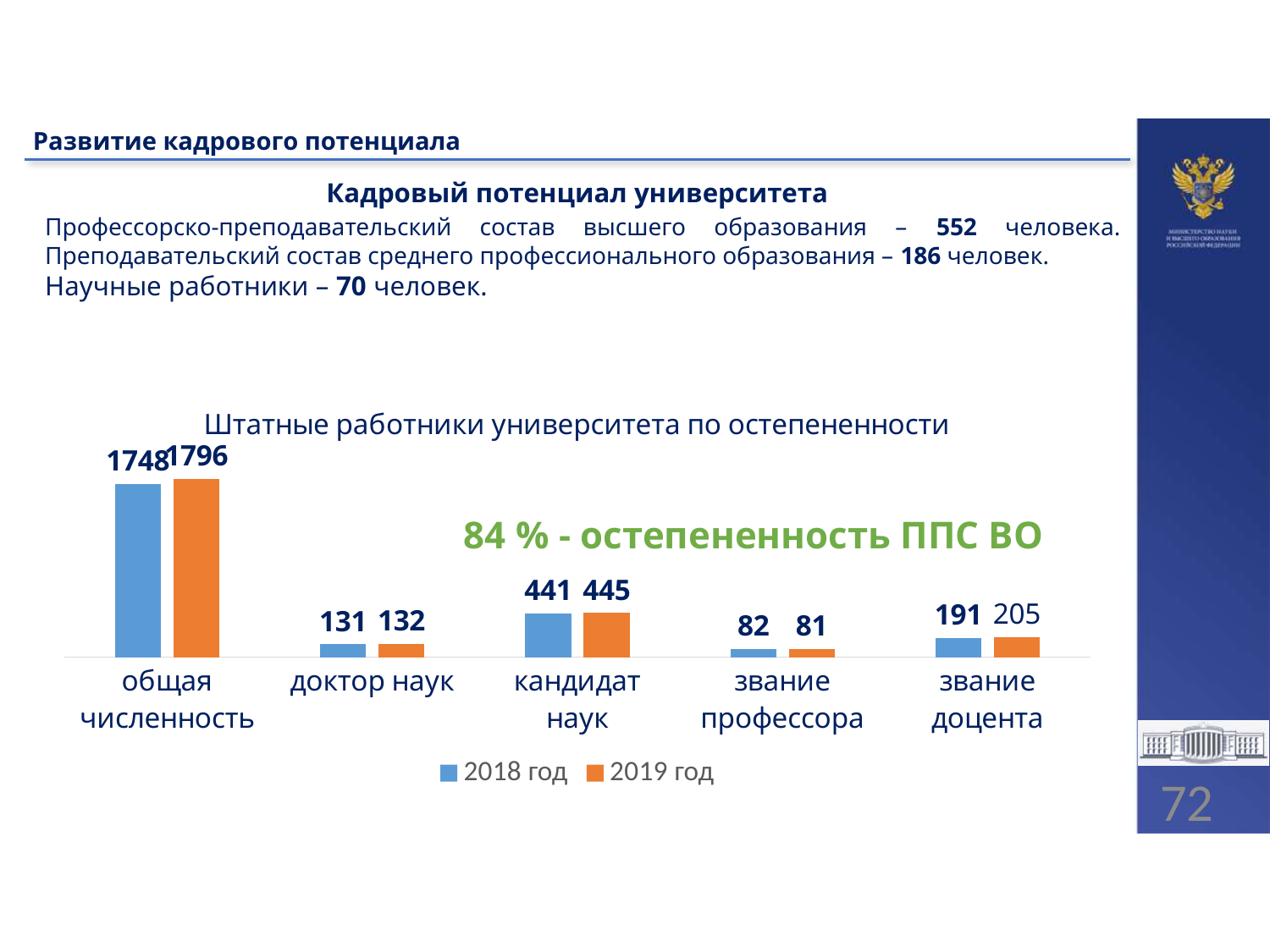
What is the value for 'звание доцента' in the 2018 год series? 191 What type of chart is 'Штатные работники университета по остепененности'? bar chart Which category has the highest value in the 2018 год series? общая численность How many series does the chart legend list? 2 For 'звание профессора', which series has the larger value, 2018 год or 2019 год? 2018 год What is the value for 'доктор наук' in the 2018 год series? 131 What is the value for 'общая численность' in the 2019 год series? 1796 What is the value for 'кандидат наук' in the 2019 год series? 445 How many categories are shown on the x axis of the chart? 5 What is the difference between the 2019 год and 2018 год values for 'общая численность'? 48 Which category has the lowest value in the 2019 год series? звание профессора What is the difference between the 2019 год and 2018 год values for 'звание доцента'? 14